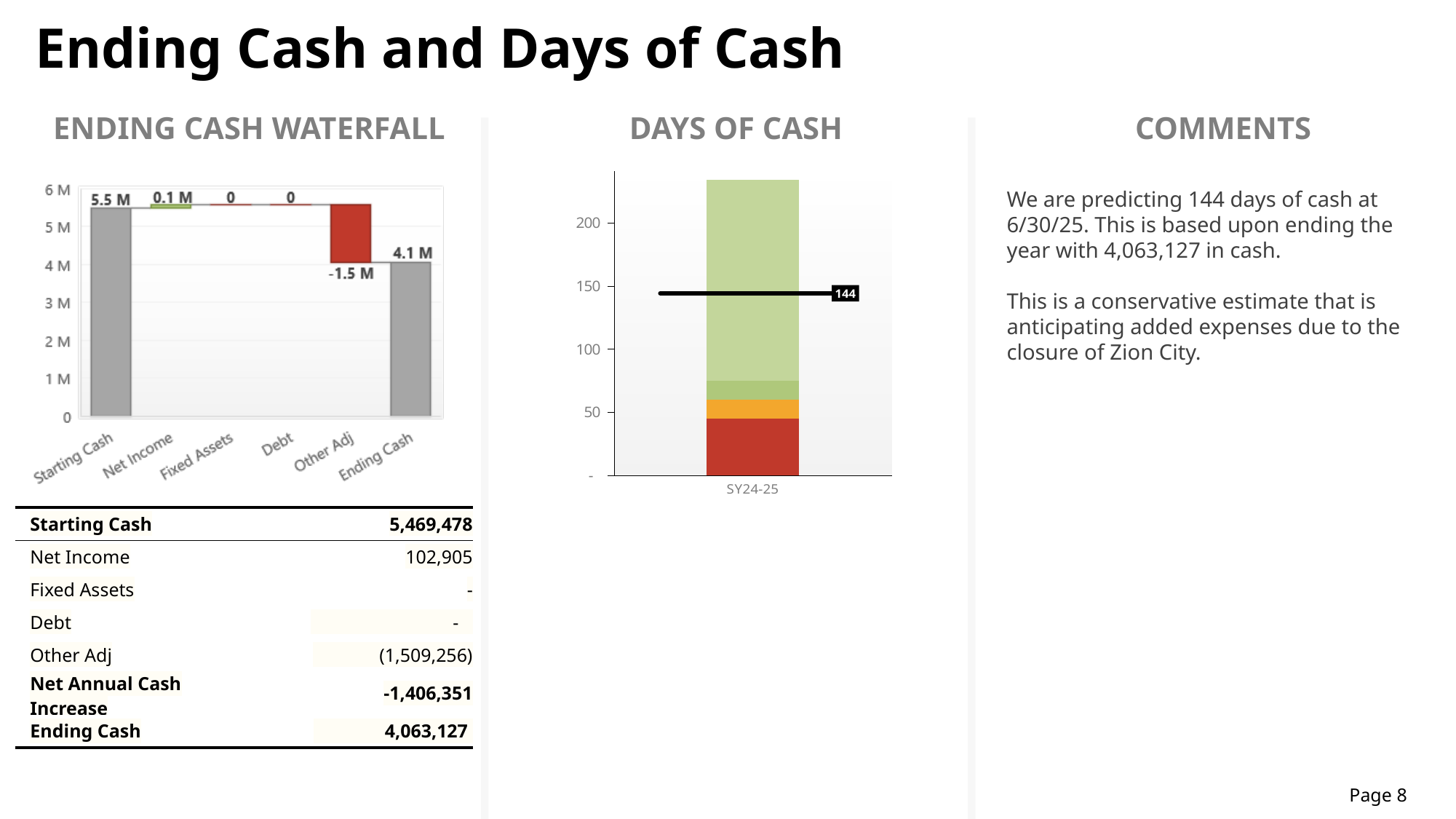
In the Ending Cash Waterfall chart, what is the value labelled for Other Adj? -1.5 M In the Ending Cash Waterfall chart, is Starting Cash larger or smaller than Ending Cash? larger In the Ending Cash Waterfall chart, what is the value labelled for Net Income? 0.1 M In the Ending Cash Waterfall chart, what is the value labelled for Ending Cash? 4.1 M In the Days of Cash chart, what is the category label on the x axis? SY24-25 In the Ending Cash Waterfall chart, which category has the highest labelled value? Starting Cash In the Ending Cash Waterfall chart, what is the value labelled for Starting Cash? 5.5 M In the Ending Cash Waterfall chart, which category has the lowest labelled value? Other Adj In the Ending Cash Waterfall chart, what is the value labelled for Debt? 0 In the Days of Cash chart, what value does the marker line indicate? 144 What kind of chart is the Days of Cash chart? bar chart In the Ending Cash Waterfall chart, how many categories are shown on the x axis? 6